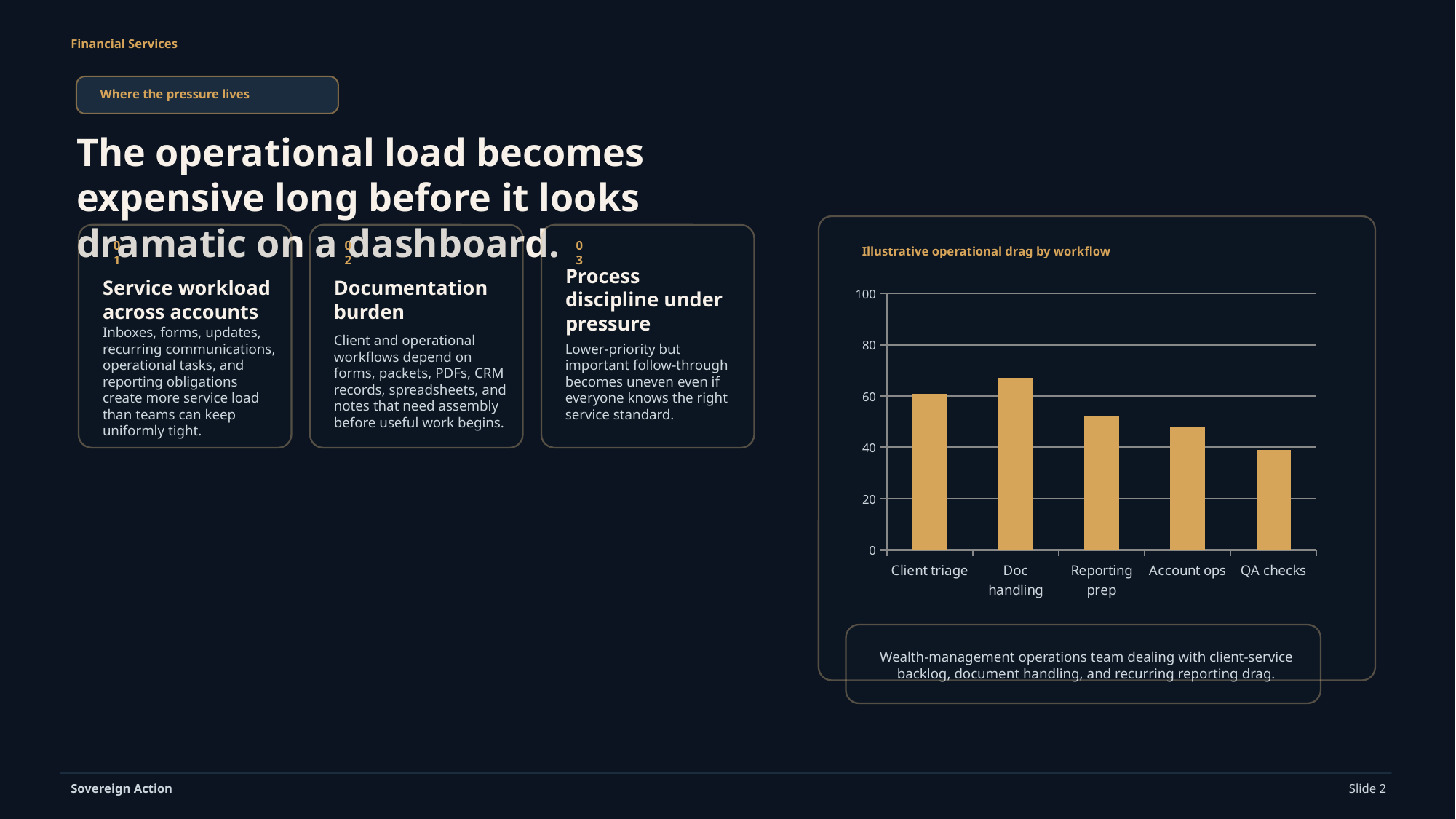
Which is larger, the value for Account ops or the value for QA checks? Account ops Do the values generally rise or fall from Doc handling to QA checks along the x axis? fall Is the value for Reporting prep greater or less than 40? greater How many workflow categories are plotted in the chart? 5 What is the title of the chart? Illustrative operational drag by workflow Which workflow has the highest operational drag in the chart? Doc handling Which workflow has the lowest operational drag in the chart? QA checks Is the value for Account ops greater or less than 60? less Which is larger, the value for Client triage or the value for Reporting prep? Client triage What kind of chart is shown on the slide? Bar chart Is the value for Doc handling greater or less than 60? greater